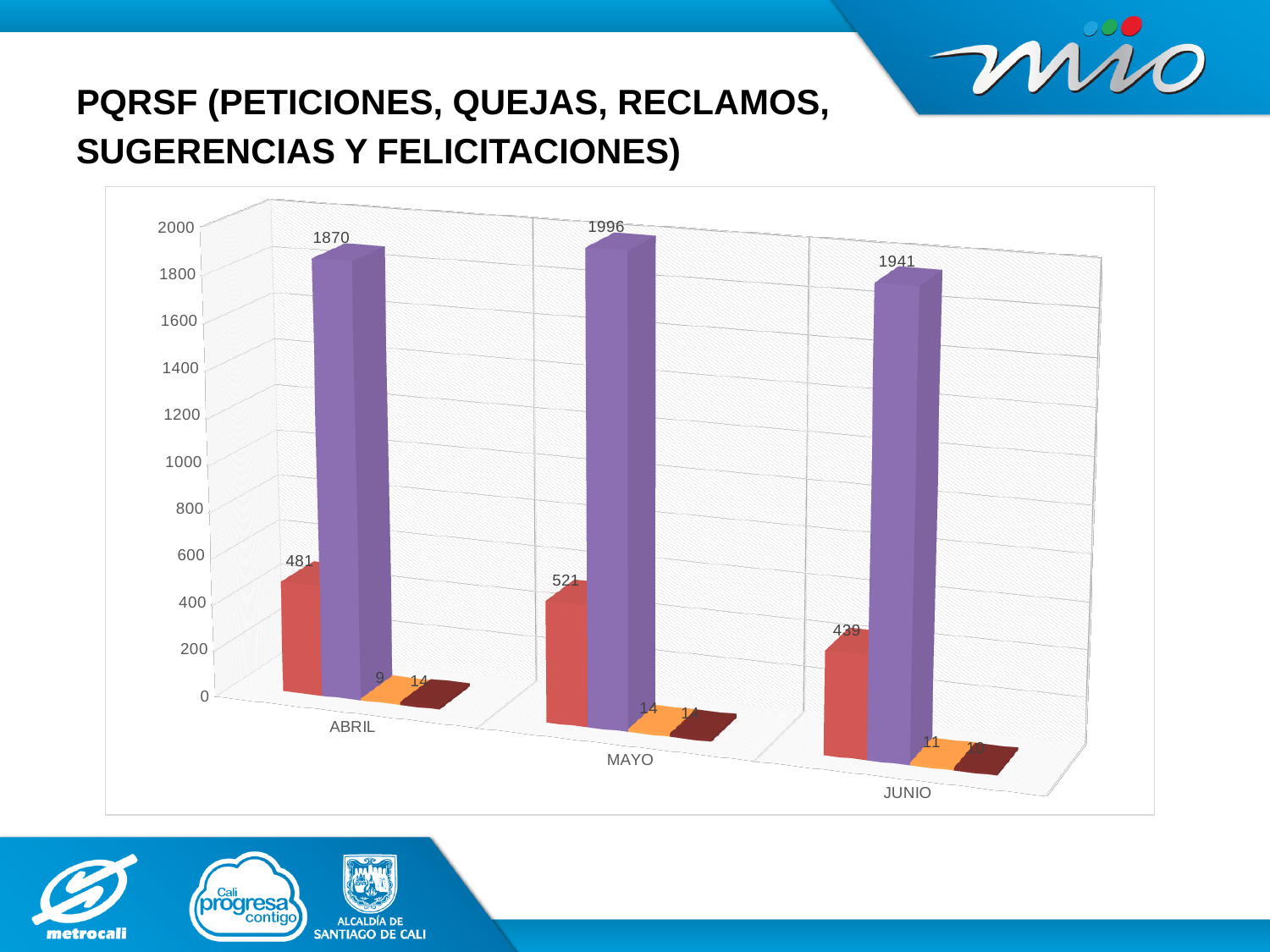
Is the value of the purple bar for JUNIO greater or less than 1800? greater How many months are shown on the x axis? 3 What is the value of the purple bar for ABRIL? 1870 In which month is the red bar lowest? JUNIO What is the value of the orange bar for ABRIL? 9 What is the value of the purple bar for MAYO? 1996 What is the value of the red bar for MAYO? 521 What is the difference between the purple bar values for MAYO and ABRIL? 126 What kind of chart is shown on the slide? bar chart What is the value of the red bar for JUNIO? 439 In which month is the purple bar highest? MAYO Which is larger, the red bar for ABRIL or the red bar for MAYO? MAYO